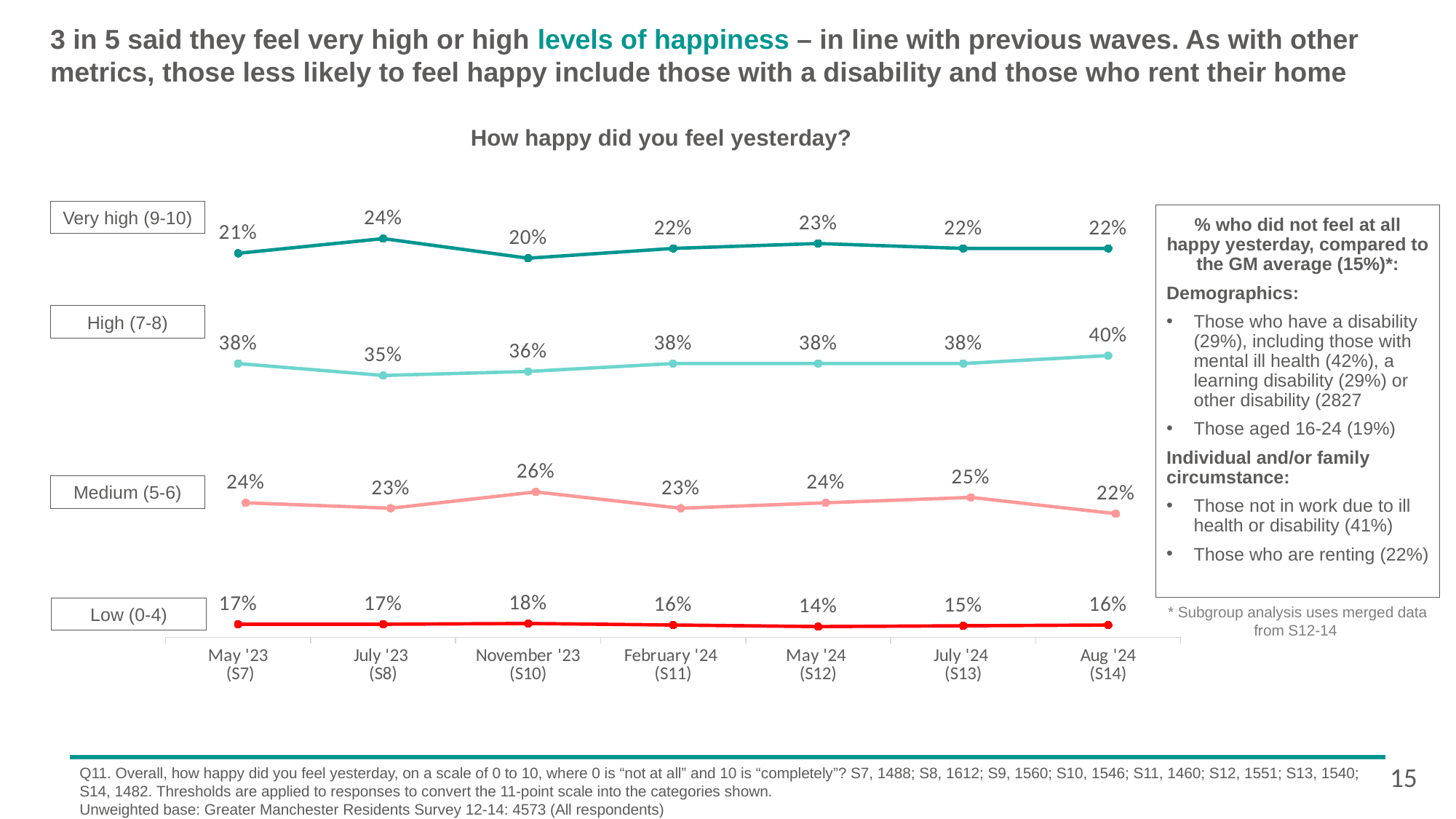
In which wave was the Very high (9-10) value lowest? November '23 (S10) How many survey waves are shown on the x axis? 7 What is the difference between the High (7-8) and Very high (9-10) values in May '23 (S7)? 17 percentage points What percentage reported Medium (5-6) happiness in November '23 (S10)? 26% What is the title of the chart? How happy did you feel yesterday? In which wave was the High (7-8) value highest? Aug '24 (S14) Which is larger in Aug '24 (S14): the Medium (5-6) value or the Low (0-4) value? Medium (5-6) What type of chart is used to show the happiness data? Line chart How many series (happiness categories) are plotted? 4 What percentage reported High (7-8) happiness in Aug '24 (S14)? 40% What percentage reported Low (0-4) happiness in May '24 (S12)? 14% What percentage reported Very high (9-10) happiness in July '23 (S8)? 24%